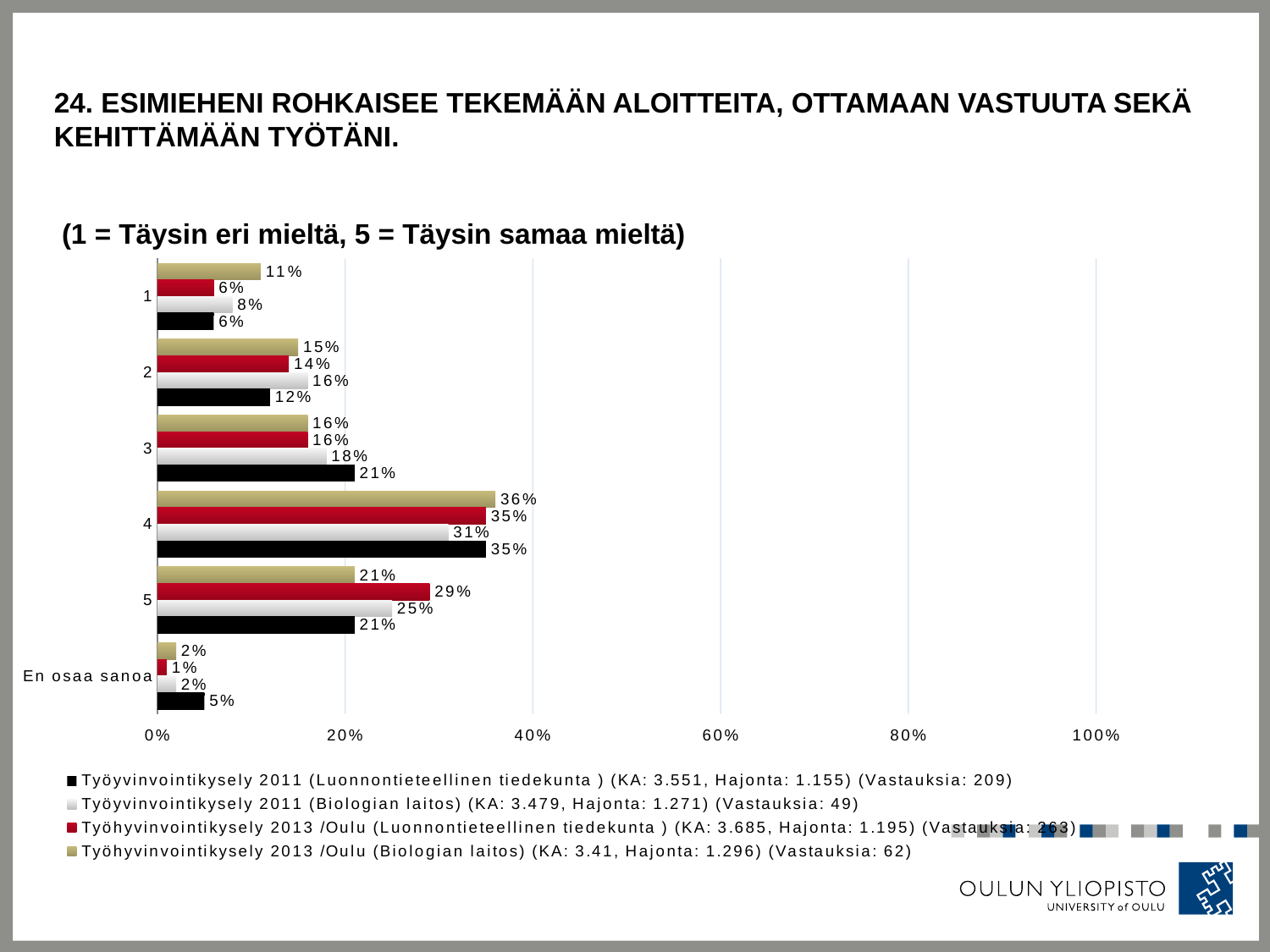
What is the number of responses (Vastauksia) listed in the legend for Työhyvinvointikysely 2013 /Oulu (Biologian laitos)? 62 Which category has the highest value in the Työyvinvointikysely 2011 (Biologian laitos) series? 4 How many series does the legend list? 4 What is the difference between the Työhyvinvointikysely 2013 /Oulu (Luonnontieteellinen tiedekunta) value and the Työyvinvointikysely 2011 (Luonnontieteellinen tiedekunta) value for category 5? 8% Is the value for category 4 in the Työyvinvointikysely 2011 (Biologian laitos) series greater or less than 40%? less What is the value for category 4 in the Työhyvinvointikysely 2013 /Oulu (Biologian laitos) series? 36% What type of chart is shown on the slide? bar chart What is the value for 'En osaa sanoa' in the Työyvinvointikysely 2011 (Luonnontieteellinen tiedekunta) series? 5% How many categories are shown on the vertical axis? 6 For category 3, which series has the larger value: Työyvinvointikysely 2011 (Luonnontieteellinen tiedekunta) or Työyvinvointikysely 2011 (Biologian laitos)? Työyvinvointikysely 2011 (Luonnontieteellinen tiedekunta) Which category has the lowest value in the Työhyvinvointikysely 2013 /Oulu (Luonnontieteellinen tiedekunta) series? En osaa sanoa What is the value for category 5 in the Työhyvinvointikysely 2013 /Oulu (Luonnontieteellinen tiedekunta) series? 29%